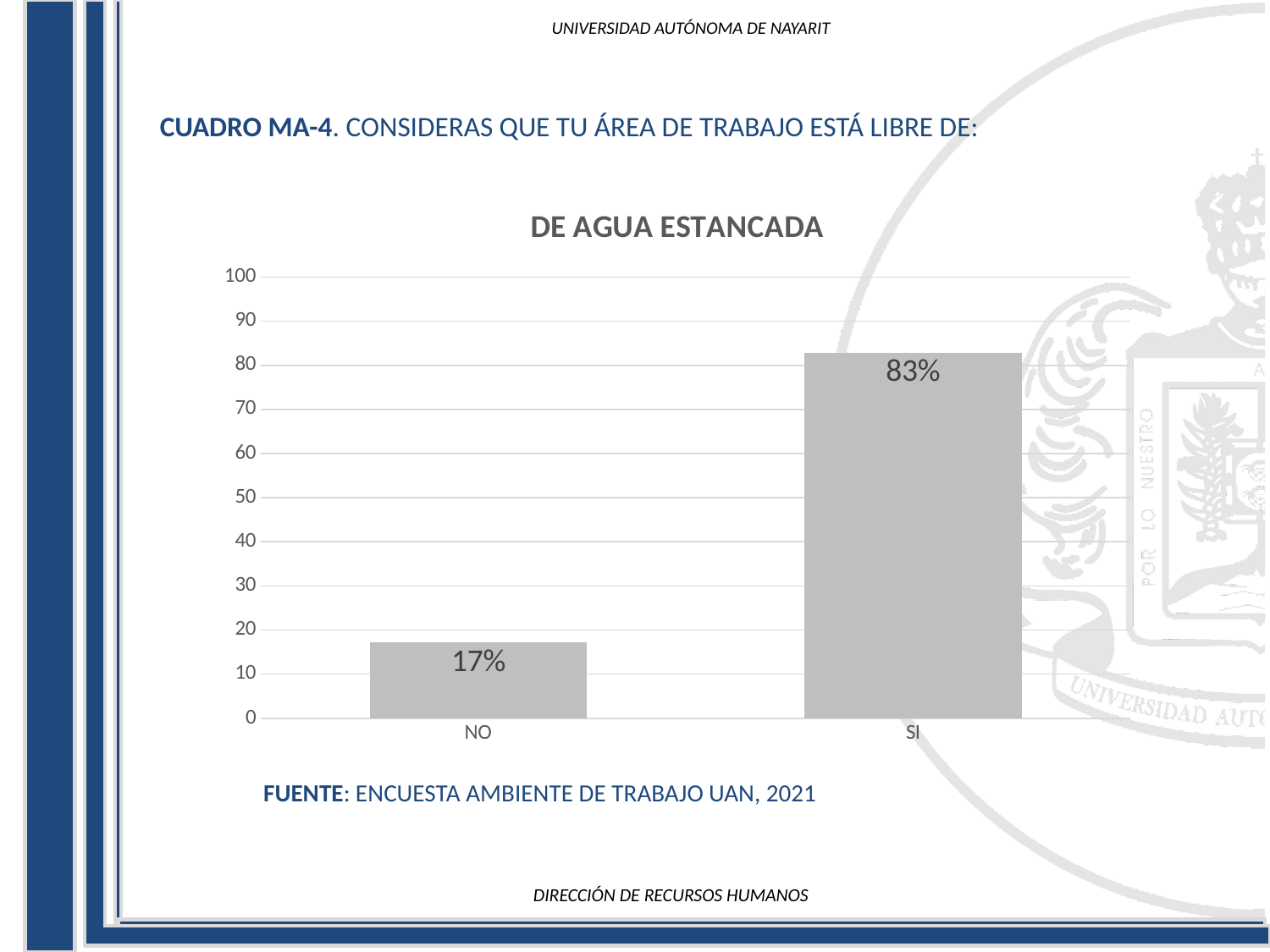
What is the difference between the values for SI and NO? 66% What is the value for SI? 83% Which category has the highest value? SI What kind of chart is shown on the slide? bar chart What is the maximum value shown on the y axis? 100 What is the title of the chart? DE AGUA ESTANCADA Which is larger, the value for NO or the value for SI? SI How many categories are shown on the x axis? 2 Which category has the lowest value? NO What is the value for NO? 17% Is the value for NO greater or less than 20? less Is the value for SI greater or less than 80? greater